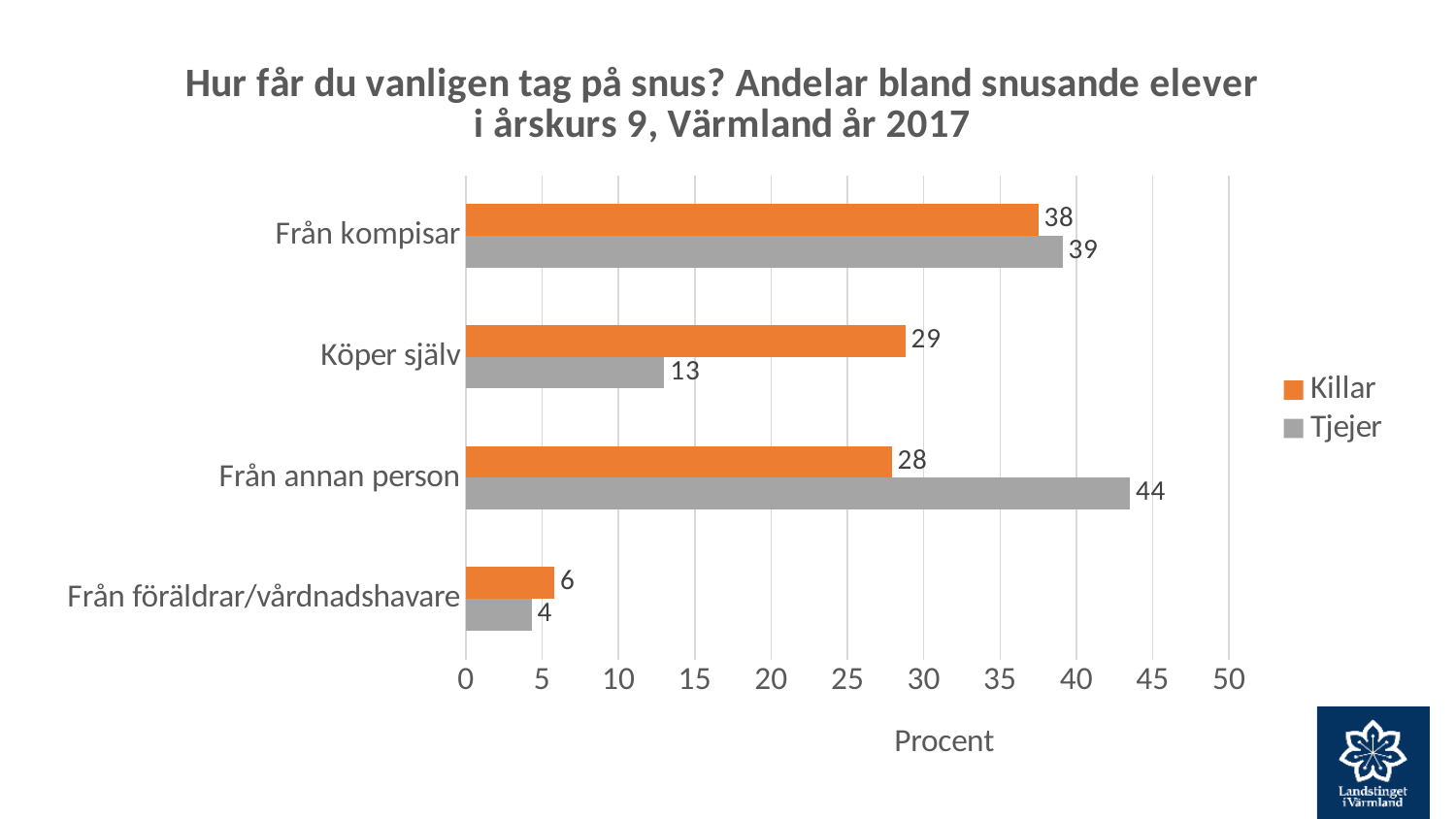
What is the label of the horizontal axis? Procent What kind of chart is shown on the slide? Bar chart In the 'Från annan person' category, which series has the larger value, Killar or Tjejer? Tjejer What is the difference between Killar and Tjejer in the 'Köper själv' category? 16 Which category has the lowest value for Killar? Från föräldrar/vårdnadshavare How many series does the legend list? 2 Which category has the highest value for Tjejer? Från annan person How many categories are shown on the chart? 4 What is the value for Tjejer in the 'Från annan person' category? 44 What is the value for Killar in the 'Köper själv' category? 29 What is the value for Tjejer in the 'Från kompisar' category? 39 Is the value for Tjejer in 'Från annan person' greater or less than 40? greater